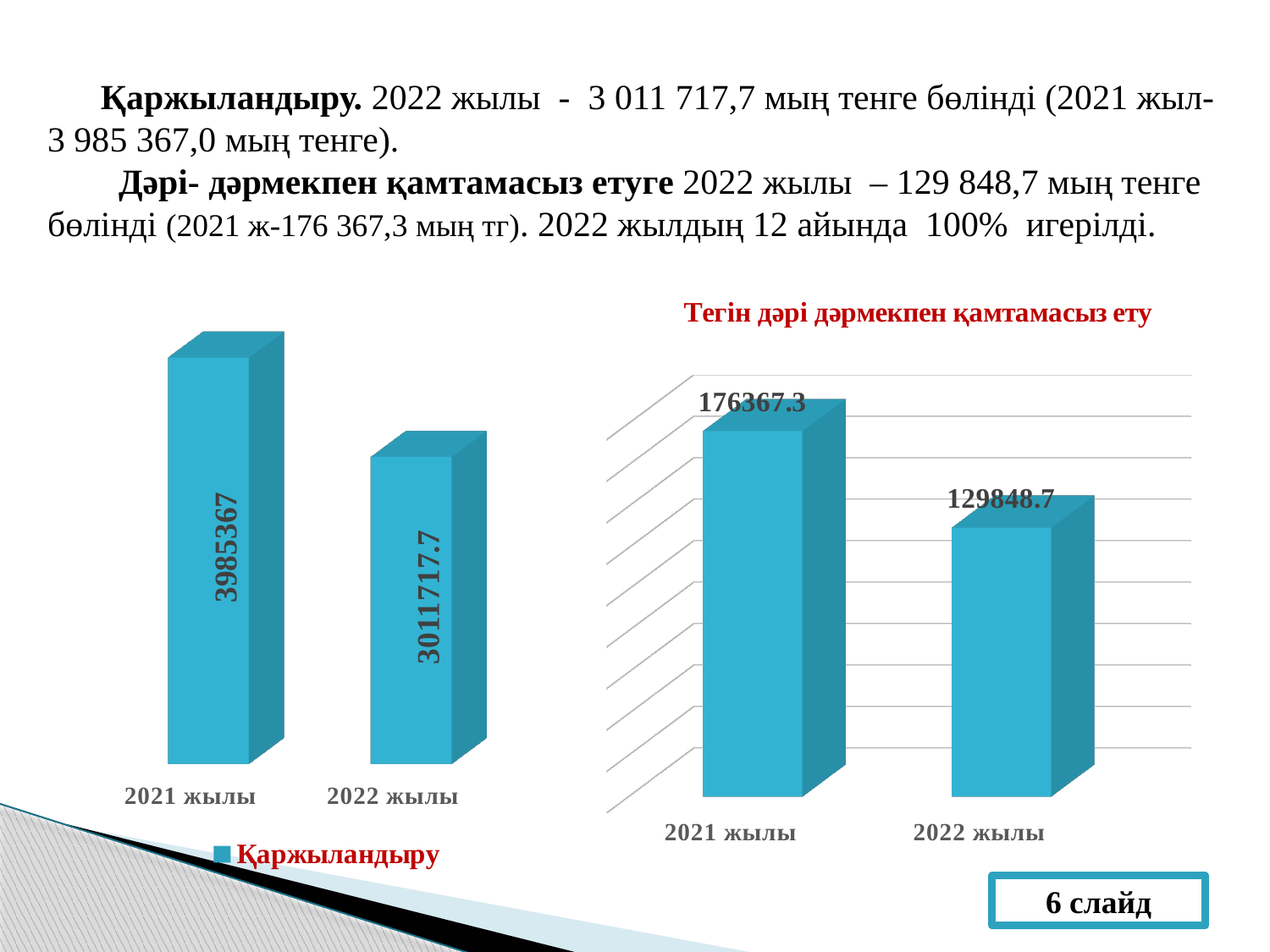
In the chart titled "Тегін дәрі дәрмекпен қамтамасыз ету", which year has the lower value? 2022 жылы In the chart titled "Тегін дәрі дәрмекпен қамтамасыз ету", is the value for 2021 жылы larger or smaller than the value for 2022 жылы? larger How many bars does the left chart (legend "Қаржыландыру") show? 2 In the left chart (legend "Қаржыландыру"), which year has the higher value? 2021 жылы In the chart titled "Тегін дәрі дәрмекпен қамтамасыз ету", what is the value for 2021 жылы? 176367.3 In the left chart (legend "Қаржыландыру"), what is the difference between the 2021 жылы and 2022 жылы values? 973649.3 In the chart titled "Тегін дәрі дәрмекпен қамтамасыз ету", what is the value for 2022 жылы? 129848.7 In the left chart (legend "Қаржыландыру"), what is the value for 2021 жылы? 3985367 In the left chart, do the values rise or fall from 2021 жылы to 2022 жылы? fall In the chart titled "Тегін дәрі дәрмекпен қамтамасыз ету", what is the difference between the 2021 жылы and 2022 жылы values? 46518.6 In the left chart (legend "Қаржыландыру"), what is the value for 2022 жылы? 3011717.7 What type of chart is the chart titled "Тегін дәрі дәрмекпен қамтамасыз ету"? bar chart